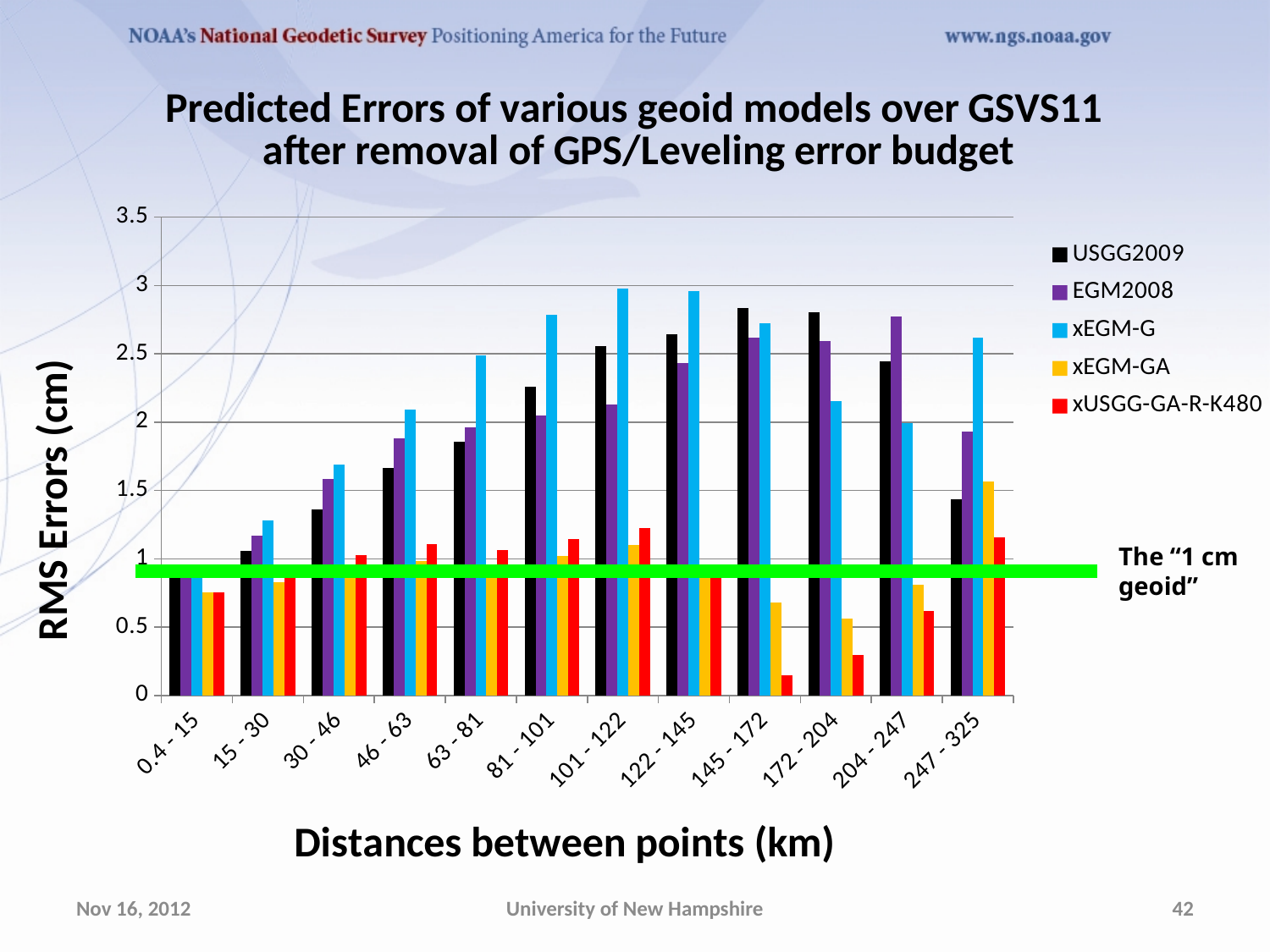
Is the value for USGG2009 at 247 - 325 km greater or less than 2? less At 247 - 325 km, which is larger: xEGM-G or USGG2009? xEGM-G Is the value for xEGM-GA at 172 - 204 km greater or less than 1? less Is the value for EGM2008 at 204 - 247 km greater or less than 2.5? greater How many series does the legend list? 5 How many distance categories are shown on the x axis? 12 What kind of chart is shown on the slide? Bar chart Which series has the lowest value at 145 - 172 km? xUSGG-GA-R-K480 What does the horizontal green line on the chart represent? The "1 cm geoid" Which series has the highest value at 101 - 122 km? xEGM-G